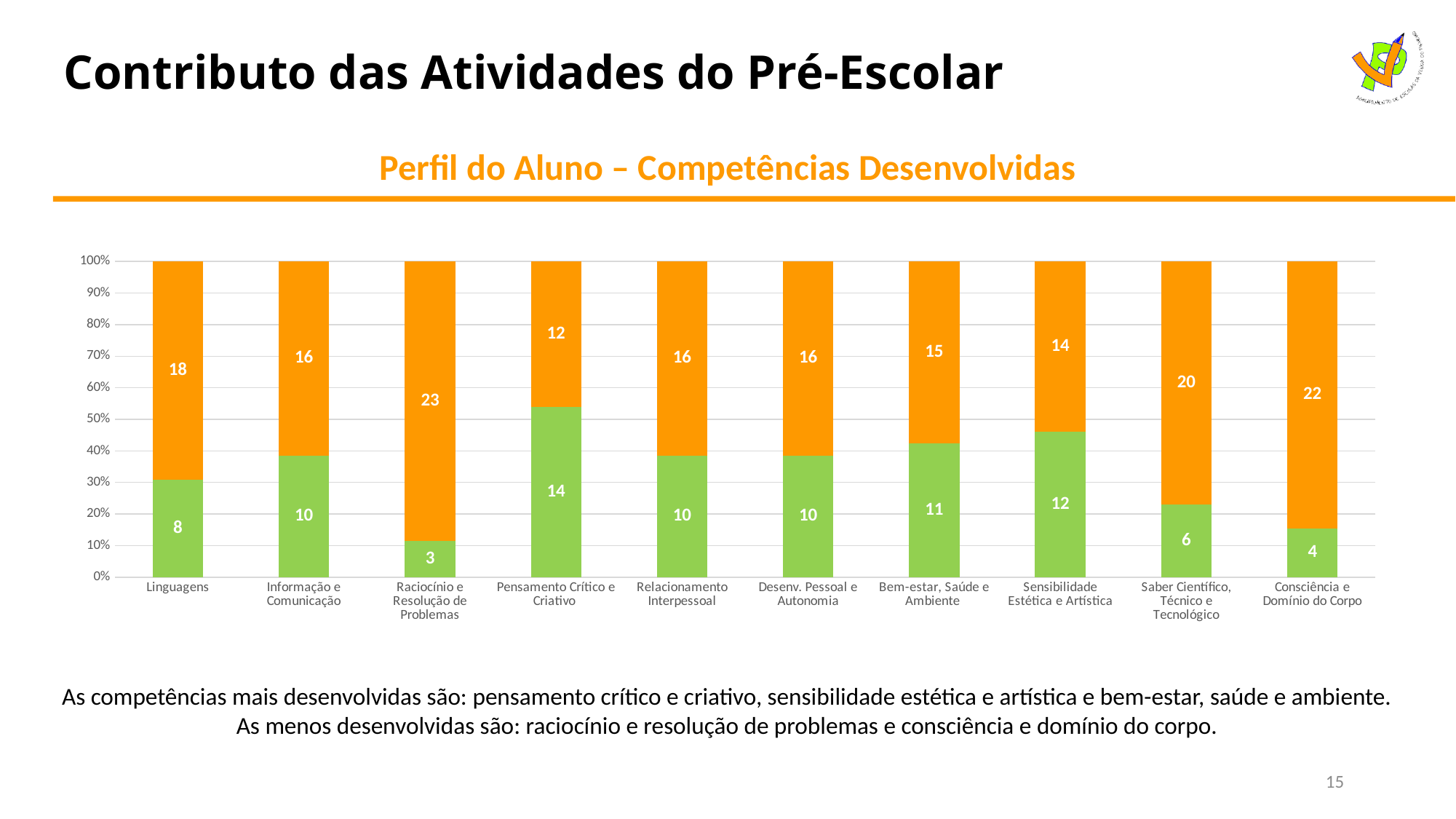
Is the green segment for Pensamento Crítico e Criativo greater or less than 50% of the bar? greater What is the total of the green and orange segments for Bem-estar, Saúde e Ambiente? 26 How many categories are shown on the x axis? 10 What kind of chart is shown on the slide? stacked bar chart What is the value of the orange segment for Raciocínio e Resolução de Problemas? 23 What is the value of the green segment for Linguagens? 8 Which is larger for Sensibilidade Estética e Artística: the green segment or the orange segment? the orange segment Which category has the lowest green segment value? Raciocínio e Resolução de Problemas What is the difference between the orange and green segment values for Saber Científico, Técnico e Tecnológico? 14 Which category has the highest green segment value? Pensamento Crítico e Criativo What is the value of the green segment for Pensamento Crítico e Criativo? 14 What is the value of the orange segment for Consciência e Domínio do Corpo? 22